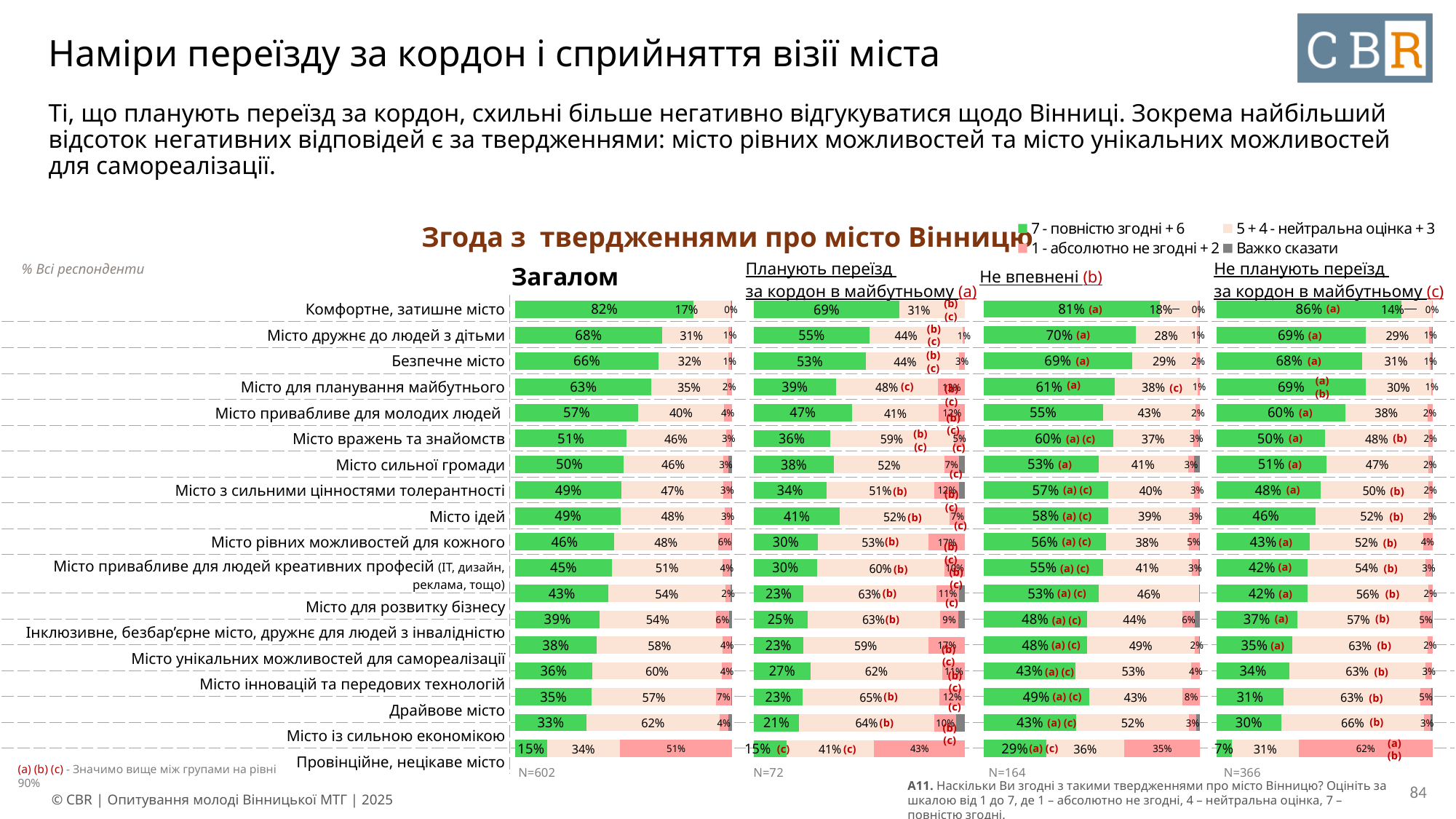
In the "Планують переїзд за кордон в майбутньому (a)" chart, what share of respondents agree (7 + 6) with "Місто рівних можливостей для кожного"? 30% In the "Загалом" chart, which statement has the lowest share of agreement (7 + 6)? Провінційне, нецікаве місто In the "Не впевнені (b)" chart, what share of respondents give a neutral rating (5 + 4 + 3) for "Місто інновацій та передових технологій"? 53% For "Безпечне місто", which group shows higher agreement (7 + 6): "Планують переїзд (a)" or "Не впевнені (b)"? Не впевнені (b) In the "Загалом" chart, what share of respondents agree (7 + 6) with the statement "Комфортне, затишне місто"? 82% What is the sample size (N) shown under the "Планують переїзд за кордон в майбутньому (a)" chart? N=72 In the "Загалом" chart, which statement has the highest share of agreement (7 + 6)? Комфортне, затишне місто What is the difference in agreement (7 + 6) with "Комфортне, затишне місто" between the "Не планують переїзд (c)" chart and the "Планують переїзд (a)" chart? 17 percentage points How many statements about the city are listed in each chart? 18 How many series does the legend list? 4 In the "Не планують переїзд за кордон в майбутньому (c)" chart, what share of respondents disagree (1 + 2) with "Провінційне, нецікаве місто"? 62% What type of chart is used on this slide? Stacked bar chart